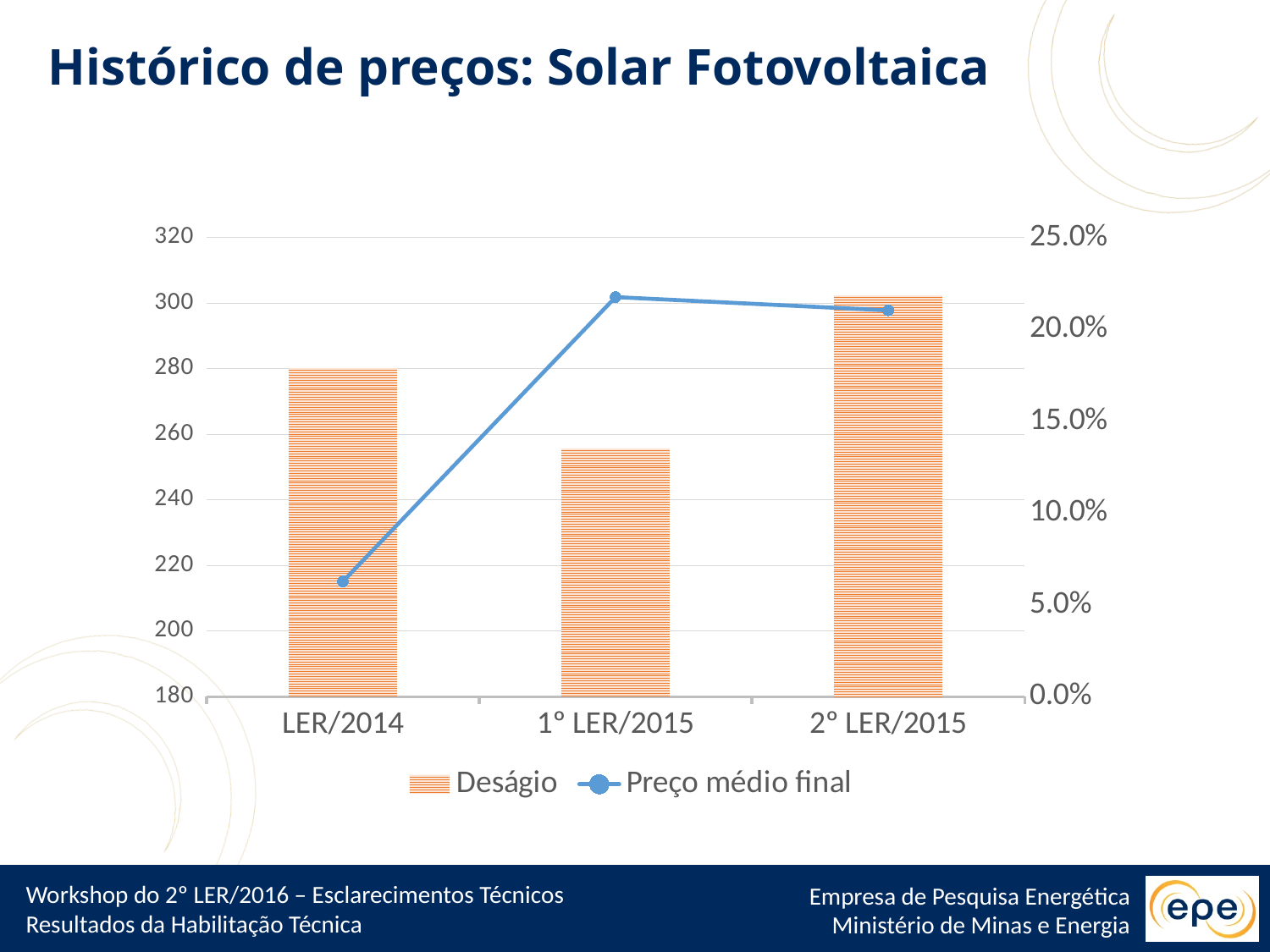
Does the Preço médio final line rise or fall from LER/2014 to 1° LER/2015? rise How many series does the legend list? 2 Which category has the lowest Preço médio final value? LER/2014 What is the title of the chart? Histórico de preços: Solar Fotovoltaica Which category has the highest Deságio bar? 2° LER/2015 What kind of chart is shown on the slide? Combined bar and line chart How many categories are shown on the x axis? 3 Which category has the lowest Deságio bar? 1° LER/2015